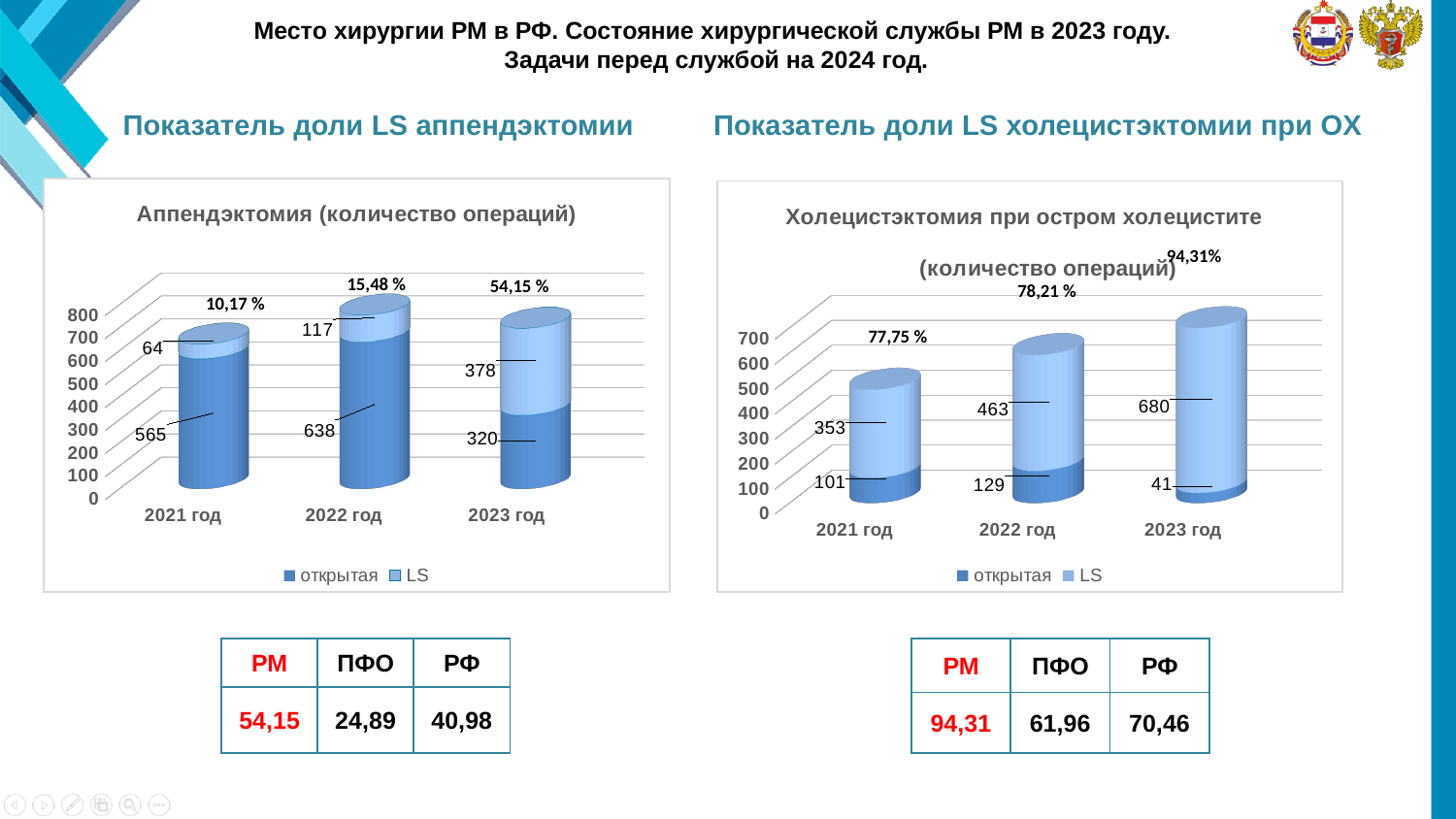
In the chart titled "Аппендэктомия (количество операций)", what is the difference between the открытая values for 2022 год and 2023 год? 318 What kind of chart is the chart titled "Холецистэктомия при остром холецистите (количество операций)"? stacked bar chart In the chart titled "Аппендэктомия (количество операций)", what is the total number of operations for 2022 год (открытая plus LS)? 755 In the chart titled "Аппендэктомия (количество операций)", how many series does the legend list? 2 In the chart titled "Аппендэктомия (количество операций)", what is the value of the LS series for 2023 год? 378 In the chart titled "Аппендэктомия (количество операций)", what is the value of the открытая series for 2022 год? 638 In the chart titled "Аппендэктомия (количество операций)", which year has the lowest LS value? 2021 год In the chart titled "Холецистэктомия при остром холецистите (количество операций)", what is the value of the LS series for 2023 год? 680 In the chart titled "Холецистэктомия при остром холецистите (количество операций)", what is the total number of operations for 2021 год (открытая plus LS)? 454 In the chart titled "Холецистэктомия при остром холецистите (количество операций)", does the LS value rise or fall from 2021 год to 2023 год? rise In the chart titled "Холецистэктомия при остром холецистите (количество операций)", which year has the highest LS value? 2023 год In the chart titled "Холецистэктомия при остром холецистите (количество операций)", what is the value of the открытая series for 2021 год? 101